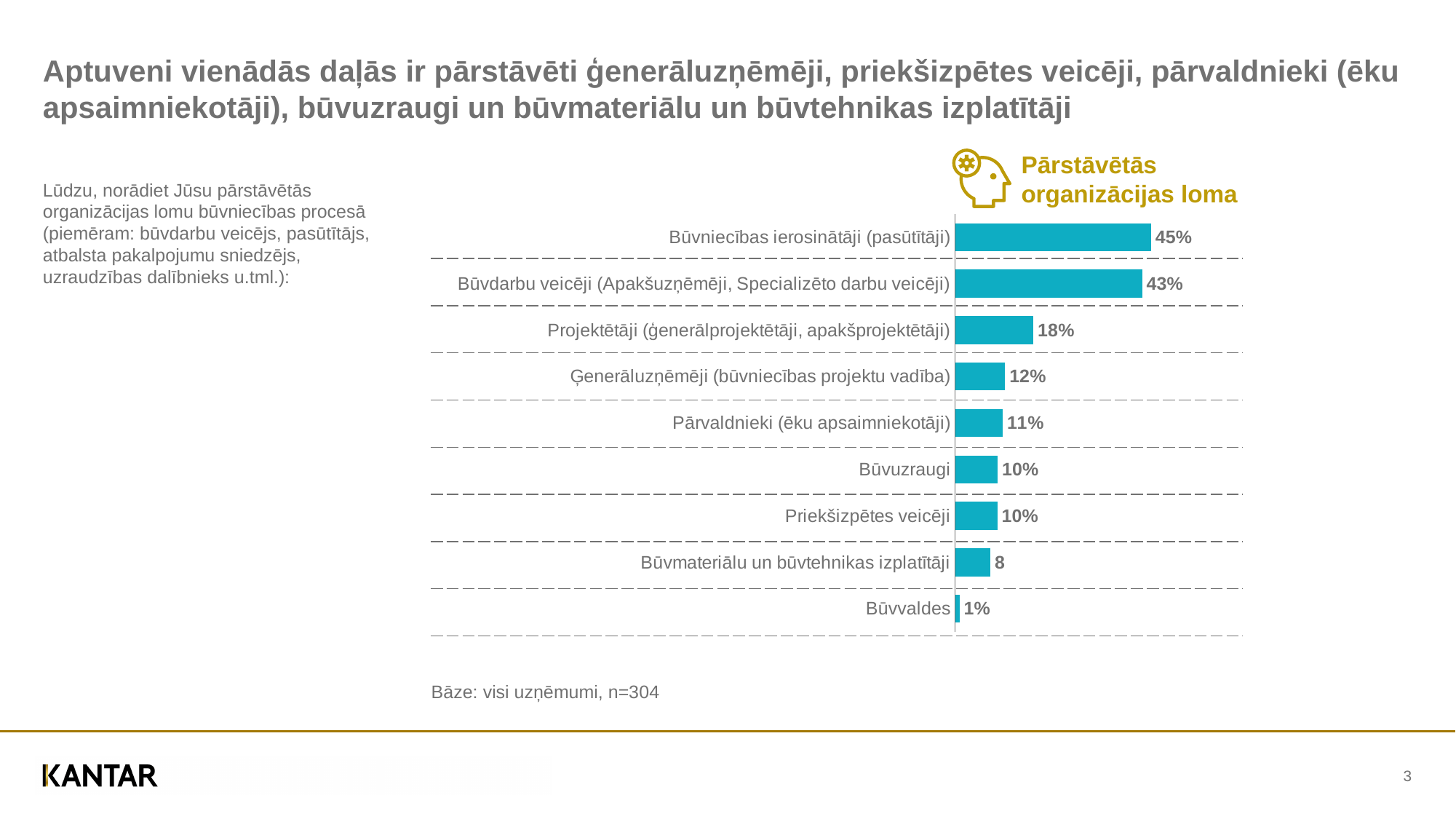
What is the value for Būvniecības ierosinātāji (pasūtītāji)? 45% How many categories are shown in the chart? 9 What kind of chart is shown on the slide? Bar chart Which category has the lowest value? Būvvaldes Which is larger, the value for Ģenerāluzņēmēji (būvniecības projektu vadība) or the value for Būvuzraugi? Ģenerāluzņēmēji (būvniecības projektu vadība) Which category has the highest value? Būvniecības ierosinātāji (pasūtītāji) What is the value for Projektētāji (ģenerālprojektētāji, apakšprojektētāji)? 18% What is the title of the chart? Pārstāvētās organizācijas loma What is the difference between the values for Būvniecības ierosinātāji (pasūtītāji) and Būvdarbu veicēji (Apakšuzņēmēji, Specializēto darbu veicēji)? 2% What is the value for Pārvaldnieki (ēku apsaimniekotāji)? 11% What is the difference between the values for Projektētāji and Ģenerāluzņēmēji (būvniecības projektu vadība)? 6% What is the value shown for Būvmateriālu un būvtehnikas izplatītāji? 8